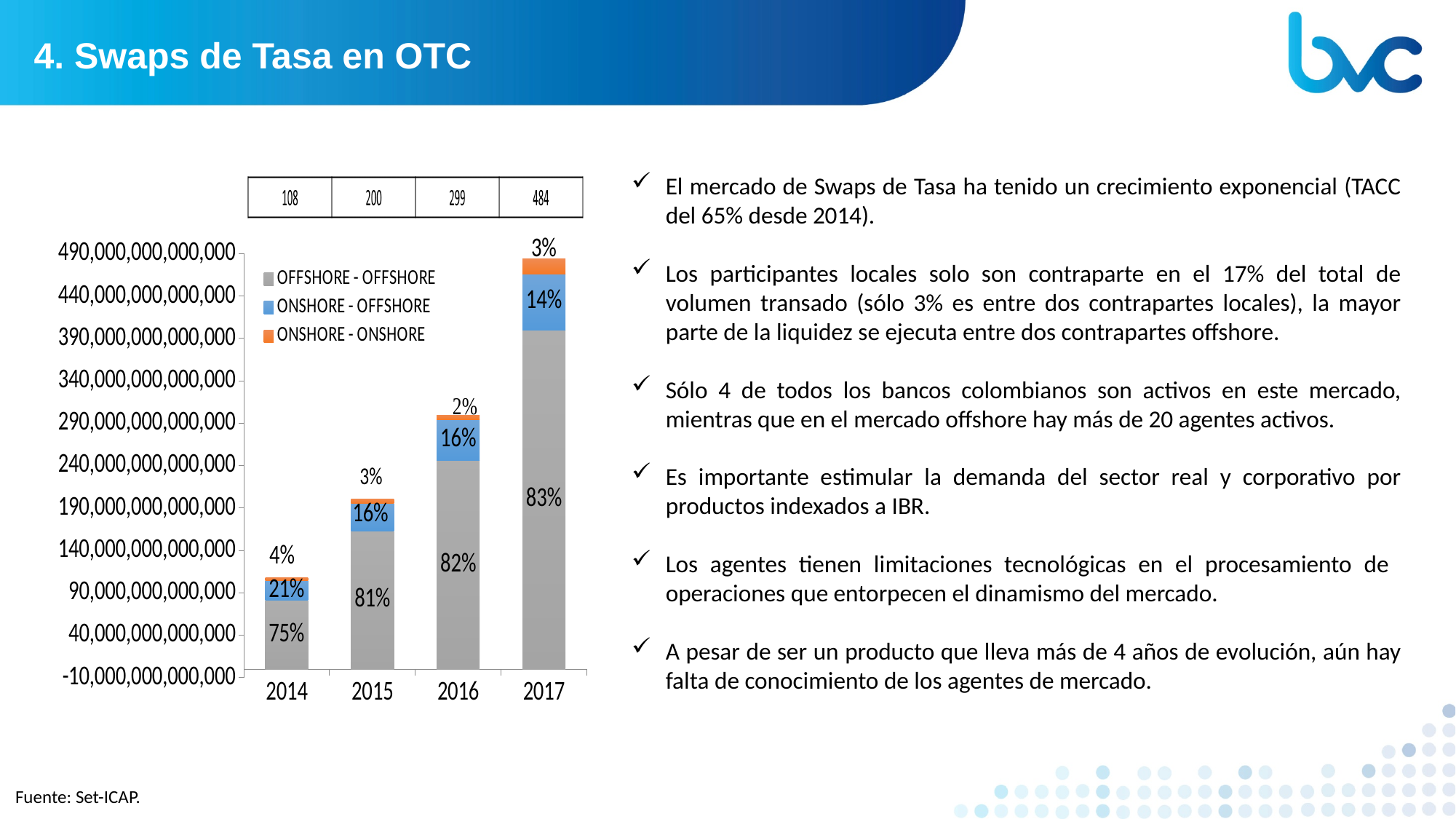
In which year is the OFFSHORE - OFFSHORE share the highest? 2017 In which year is the ONSHORE - ONSHORE share the lowest? 2016 Is the total height of the 2014 bar greater or less than 140,000,000,000,000? less How many series does the chart legend list? 3 What percentage of the 2014 bar is OFFSHORE - OFFSHORE? 75% What type of chart is shown on the slide? Stacked bar chart How many years are shown on the x axis of the chart? 4 What is the ONSHORE - OFFSHORE share shown for 2017? 14% Is the total height of the 2017 bar greater or less than 440,000,000,000,000? greater What is the ONSHORE - ONSHORE share shown for 2015? 3% Which year has the larger ONSHORE - OFFSHORE share, 2015 or 2017? 2015 By how many percentage points does the OFFSHORE - OFFSHORE share in 2017 exceed that in 2014? 8 percentage points